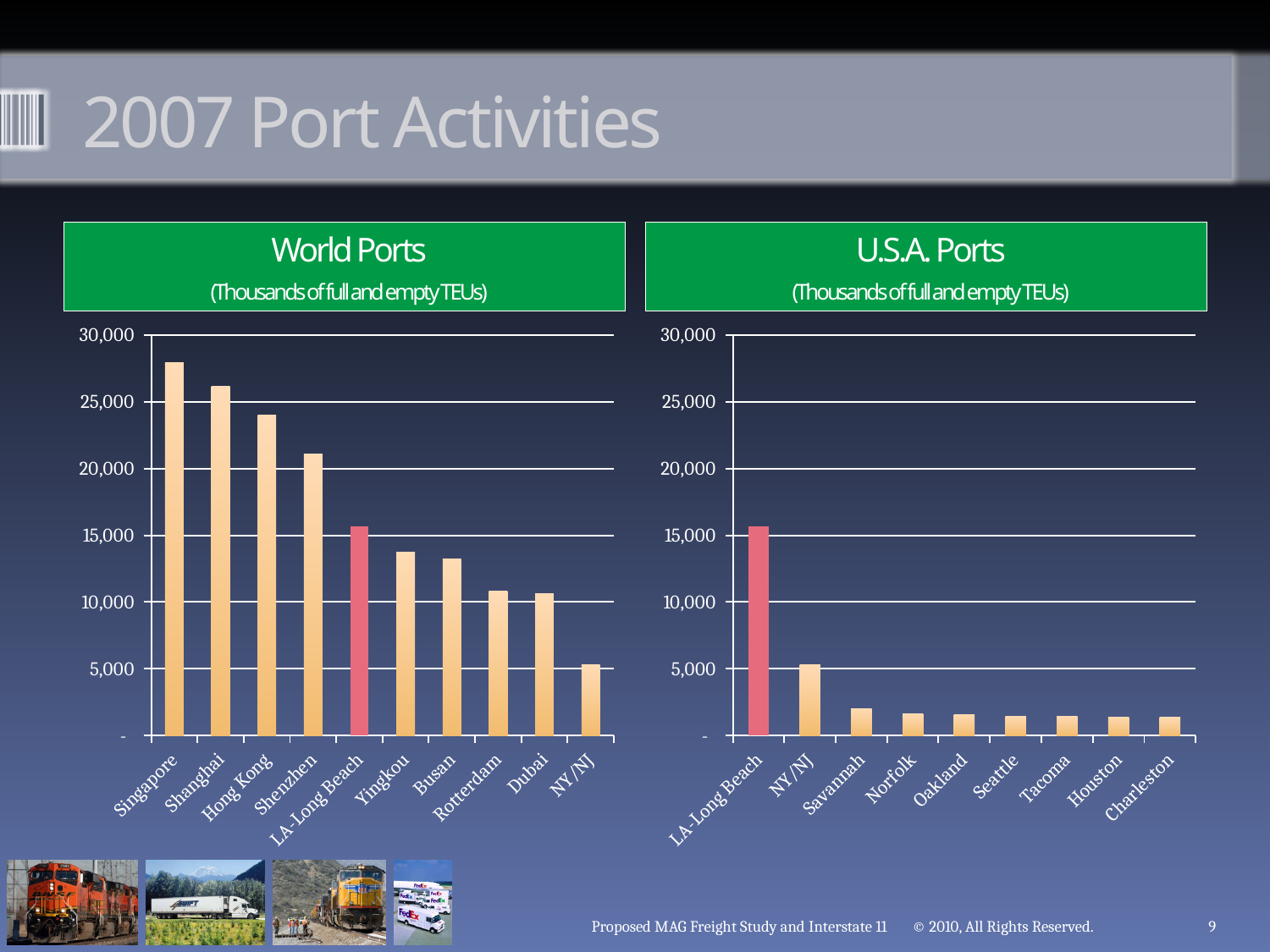
What kind of chart is the World Ports chart? bar chart In the World Ports chart, is the value for Singapore greater or less than 25,000? greater In the World Ports chart, which port has the lowest value? NY/NJ In the U.S.A. Ports chart, which port has the highest value? LA-Long Beach How many ports are shown in the World Ports chart? 10 In the U.S.A. Ports chart, do the values rise or fall from left to right? fall In the World Ports chart, is the value for Busan greater or less than 15,000? less What unit is given in the subtitle of the U.S.A. Ports chart? Thousands of full and empty TEUs In the World Ports chart, which port has the highest value? Singapore In the World Ports chart, which is larger, the value for Shanghai or the value for Hong Kong? Shanghai How many ports are shown in the U.S.A. Ports chart? 9 In the U.S.A. Ports chart, is the value for Savannah greater or less than 5,000? less